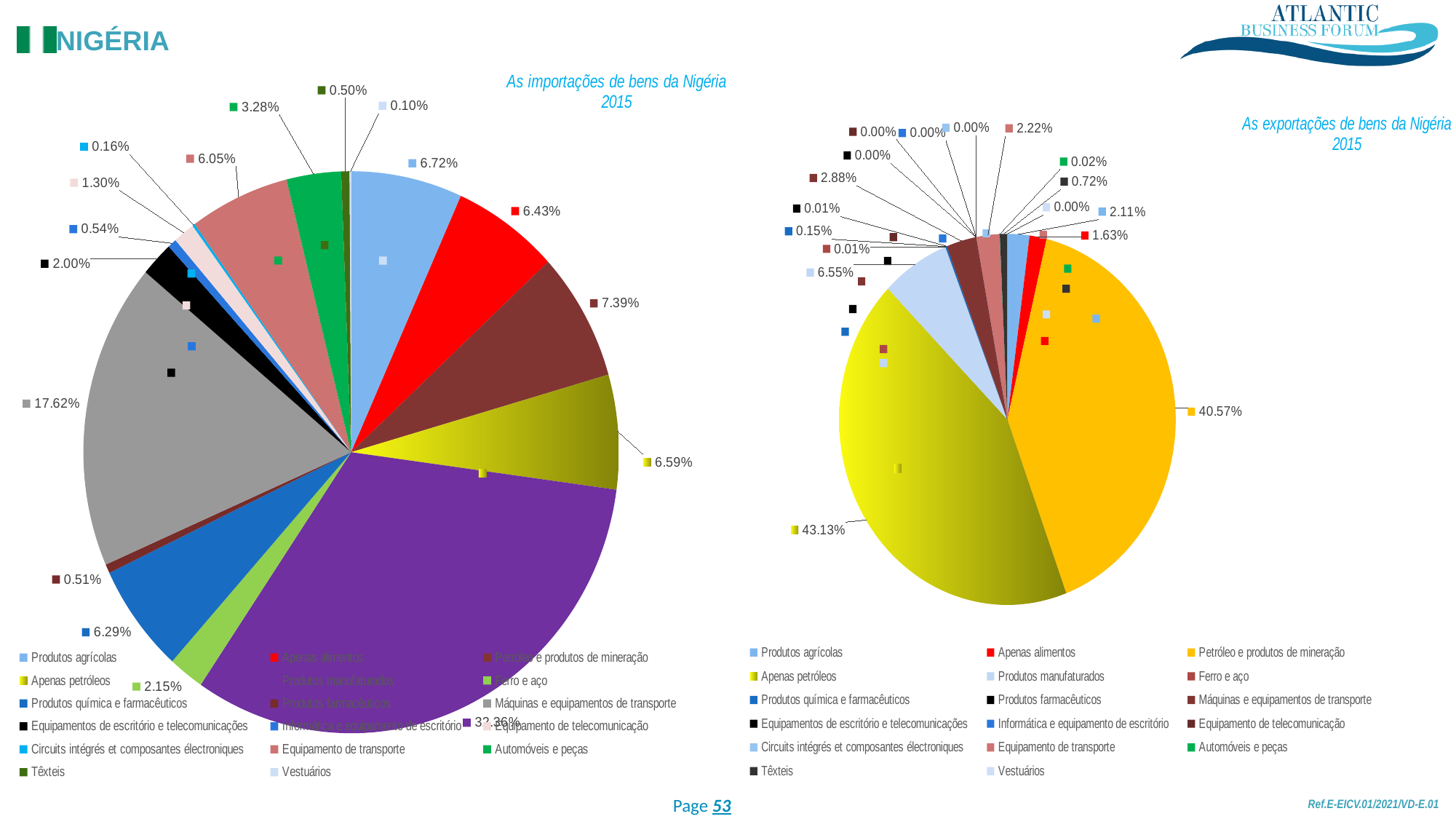
How many categories does the legend of the exports chart (As exportações de bens da Nigéria 2015) list? 17 In the imports chart (As importações de bens da Nigéria 2015), what is the difference between the shares of Produtos manufaturados and Máquinas e equipamentos de transporte? 14.74% What is the title of the chart on the left of the slide? As importações de bens da Nigéria 2015 In the imports chart (As importações de bens da Nigéria 2015), which category has the largest share? Produtos manufaturados In the imports chart (As importações de bens da Nigéria 2015), what is the share for Produtos manufaturados? 32.36% What kind of charts are shown on the slide? Pie charts In the exports chart (As exportações de bens da Nigéria 2015), what is the share for Apenas petróleos? 43.13% In the exports chart (As exportações de bens da Nigéria 2015), what is the share for Petróleo e produtos de mineração? 40.57% In the exports chart (As exportações de bens da Nigéria 2015), what is the share for Produtos manufaturados? 6.55% In the exports chart (As exportações de bens da Nigéria 2015), which is larger: the share for Apenas petróleos or the share for Petróleo e produtos de mineração? Apenas petróleos In the imports chart (As importações de bens da Nigéria 2015), what is the share for Máquinas e equipamentos de transporte? 17.62% In the imports chart (As importações de bens da Nigéria 2015), which category has the smallest share? Vestuários